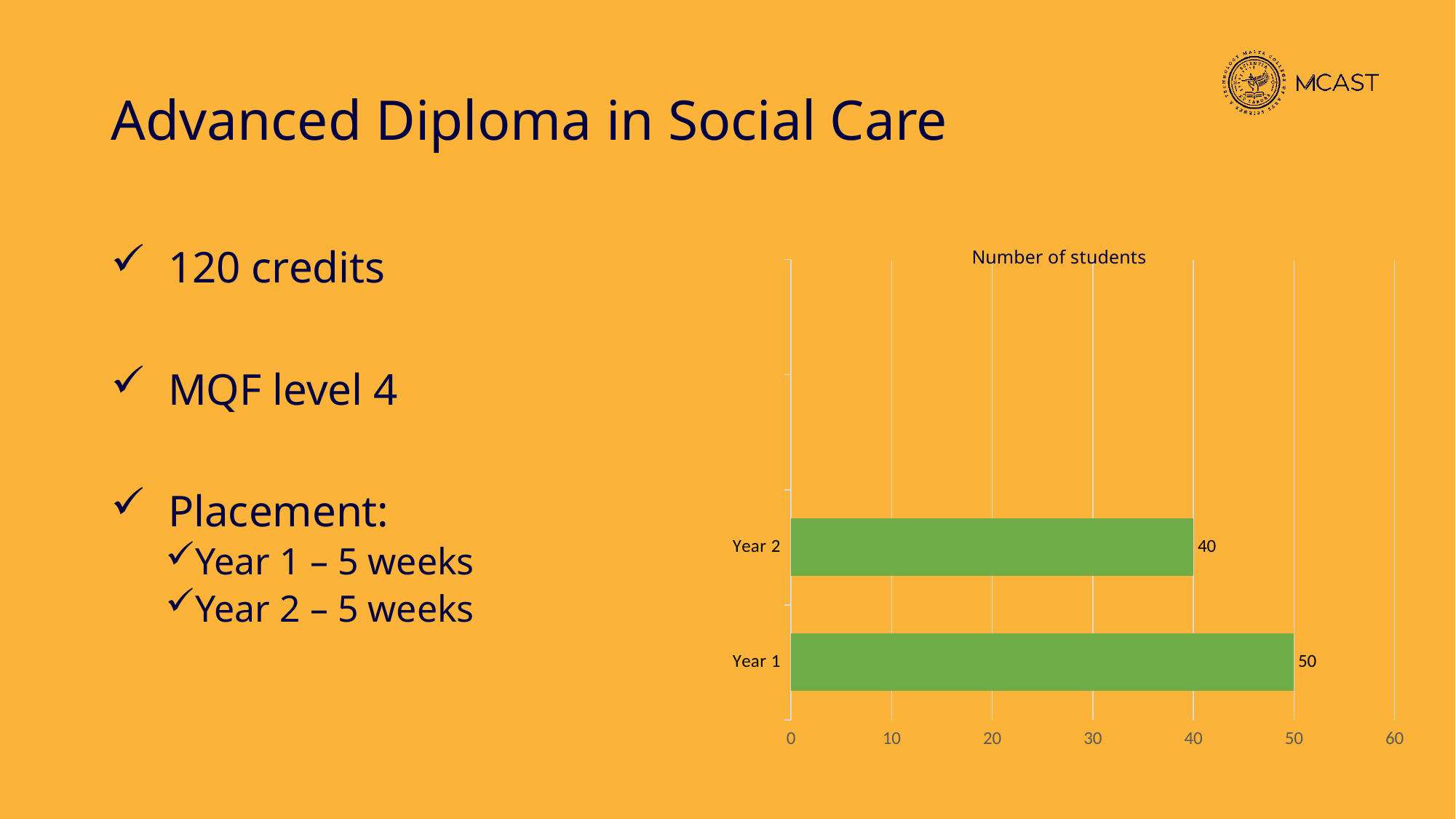
Which year has the lowest number of students? Year 2 Which has more students, Year 1 or Year 2? Year 1 What is the title of the chart? Number of students Is the value for Year 1 greater or less than 60? less What kind of chart is shown on the slide? bar chart Is the value for Year 2 greater or less than 30? greater What is the number of students for Year 2? 40 What is the number of students for Year 1? 50 Which year has the highest number of students? Year 1 How many categories are shown in the chart? 2 What is the difference in number of students between Year 1 and Year 2? 10 What is the highest value shown on the chart's horizontal axis? 60